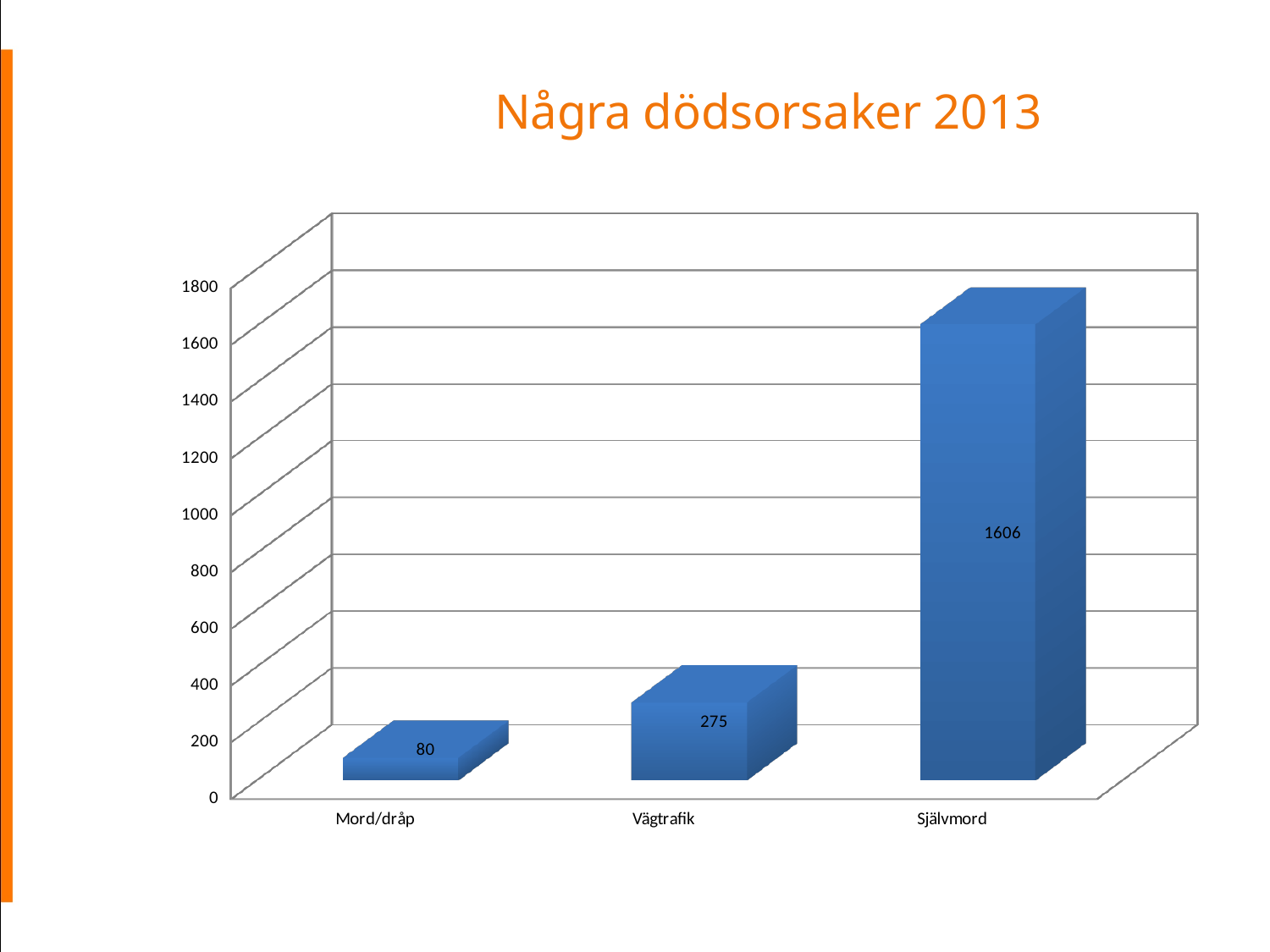
Is the value for Självmord greater or less than 1400? greater What is the value for Vägtrafik? 275 What is the title of the slide? Några dödsorsaker 2013 What is the value for Mord/dråp? 80 What is the value for Självmord? 1606 What kind of chart is shown on the slide? bar chart Which is larger, the value for Vägtrafik or the value for Mord/dråp? Vägtrafik What is the difference between the values for Vägtrafik and Mord/dråp? 195 How many categories are shown in the chart? 3 What is the difference between the values for Självmord and Vägtrafik? 1331 Which category has the lowest value? Mord/dråp Which category has the highest value? Självmord